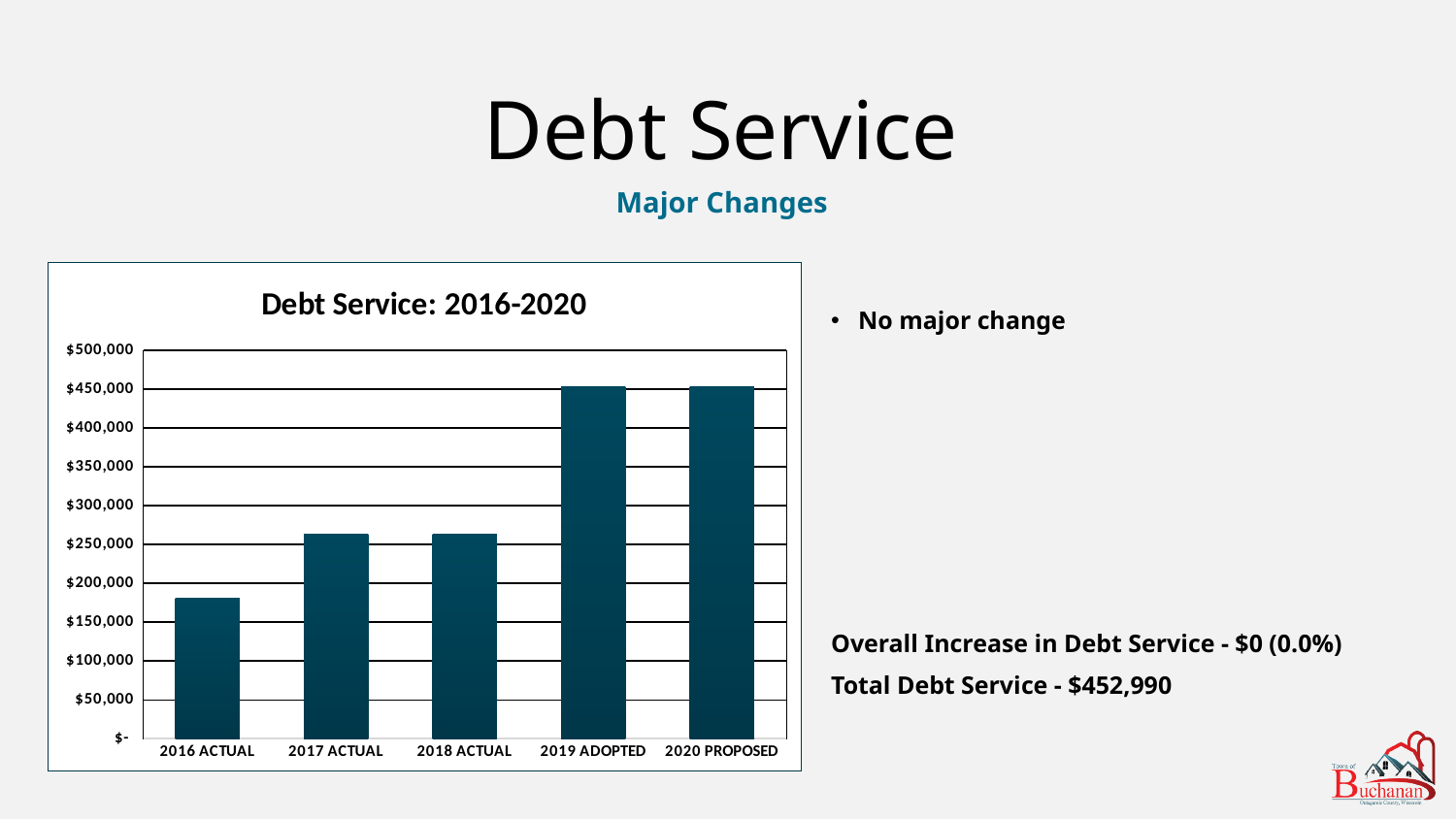
How many categories are shown on the x axis of the chart? 5 Is the value for 2016 ACTUAL greater or less than $150,000? greater Which is larger, the value for 2016 ACTUAL or the value for 2017 ACTUAL? 2017 ACTUAL Is the value for 2018 ACTUAL greater or less than $300,000? less What kind of chart is shown on the slide? bar chart Is the value for 2016 ACTUAL greater or less than $200,000? less What is the title of the chart? Debt Service: 2016-2020 Do the values generally rise or fall from 2016 ACTUAL to 2020 PROPOSED? rise Which category has the lowest value in the chart? 2016 ACTUAL